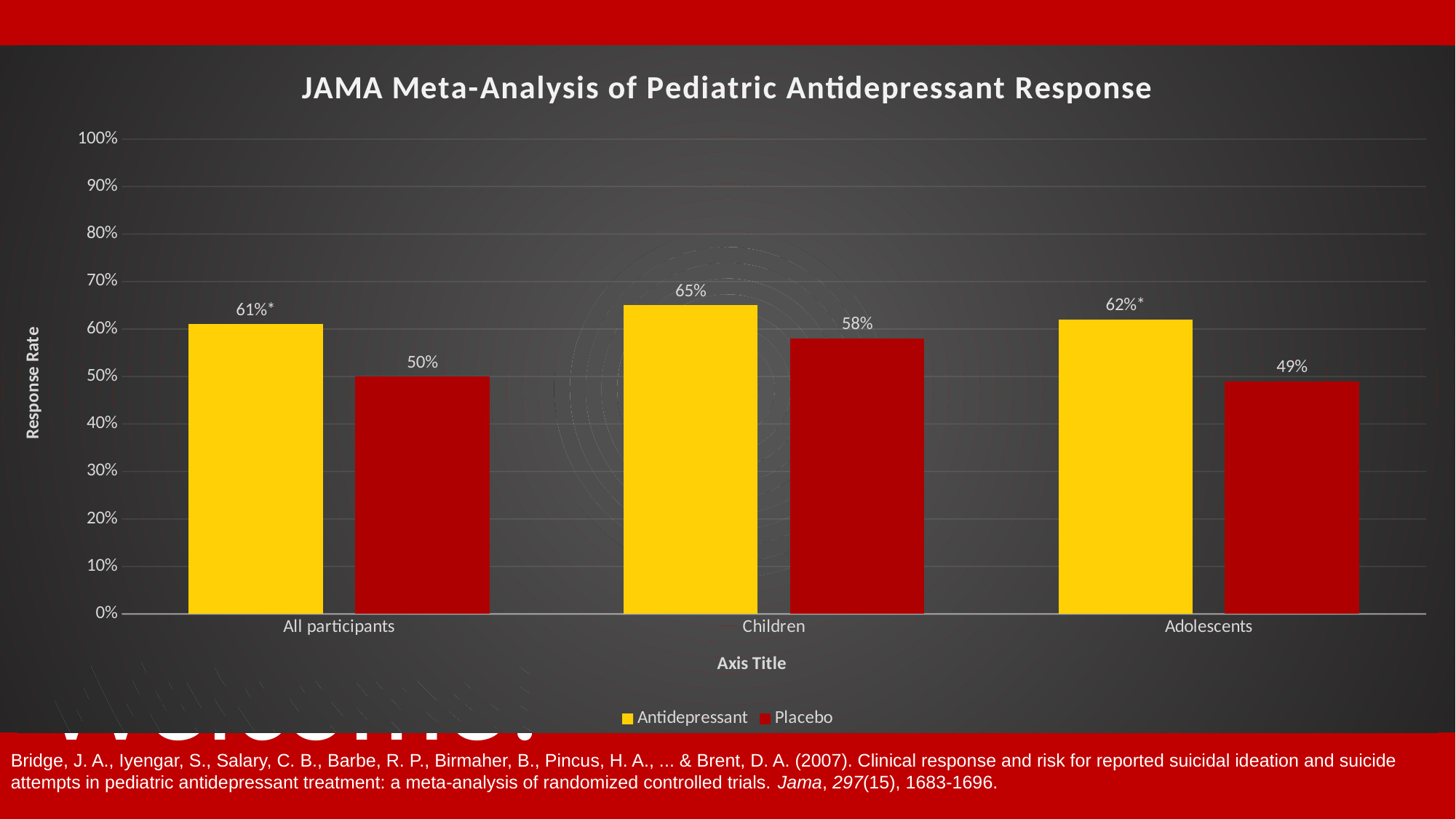
What is the title of the chart? JAMA Meta-Analysis of Pediatric Antidepressant Response What is the difference between the Antidepressant and Placebo response rates for Children? 7% Which is larger for All participants, the Antidepressant or the Placebo response rate? Antidepressant What is the Placebo response rate for Adolescents? 49% Which category has the lowest Placebo response rate? Adolescents What kind of chart is shown on the slide? Bar chart Which category has the highest Antidepressant response rate? Children What is the Placebo response rate for All participants? 50% How many series does the legend list? 2 What is the difference between the Antidepressant and Placebo response rates for Adolescents? 13% How many categories are shown on the x axis? 3 What is the Antidepressant response rate for Children? 65%